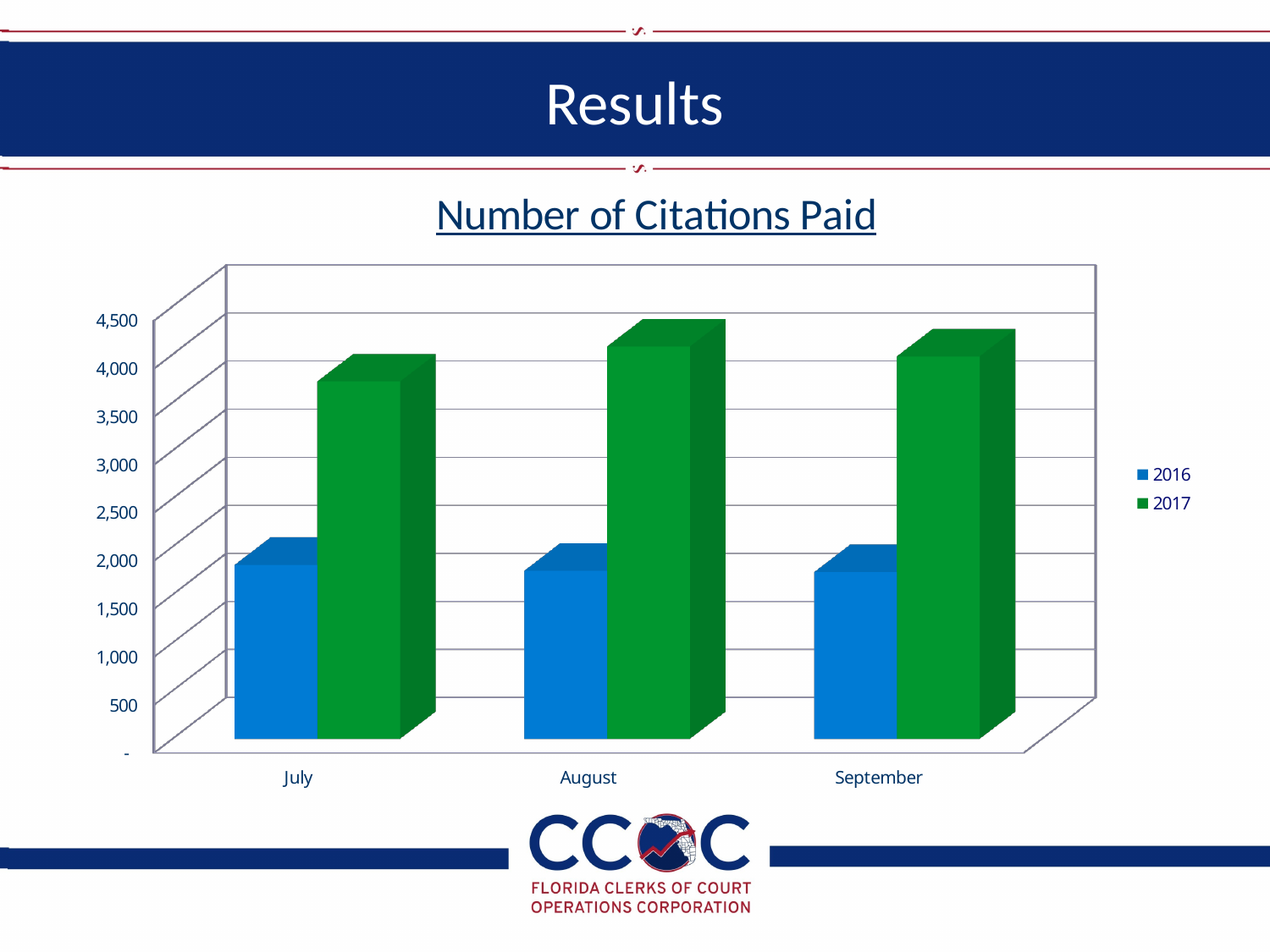
What kind of chart is shown on the slide? bar chart Is the value for 2016 in July greater or less than 2,500? less How many series does the legend list? 2 Is the value for 2016 in September greater or less than 1,500? greater Which colour represents the 2017 series? green Is the value for 2017 in July greater or less than 3,000? greater Which is larger in August, the value for 2016 or 2017? 2017 What is the title of the chart? Number of Citations Paid Which series has the higher values in every month, 2016 or 2017? 2017 For the 2017 series, which is larger, July or August? August How many months are shown on the x axis? 3